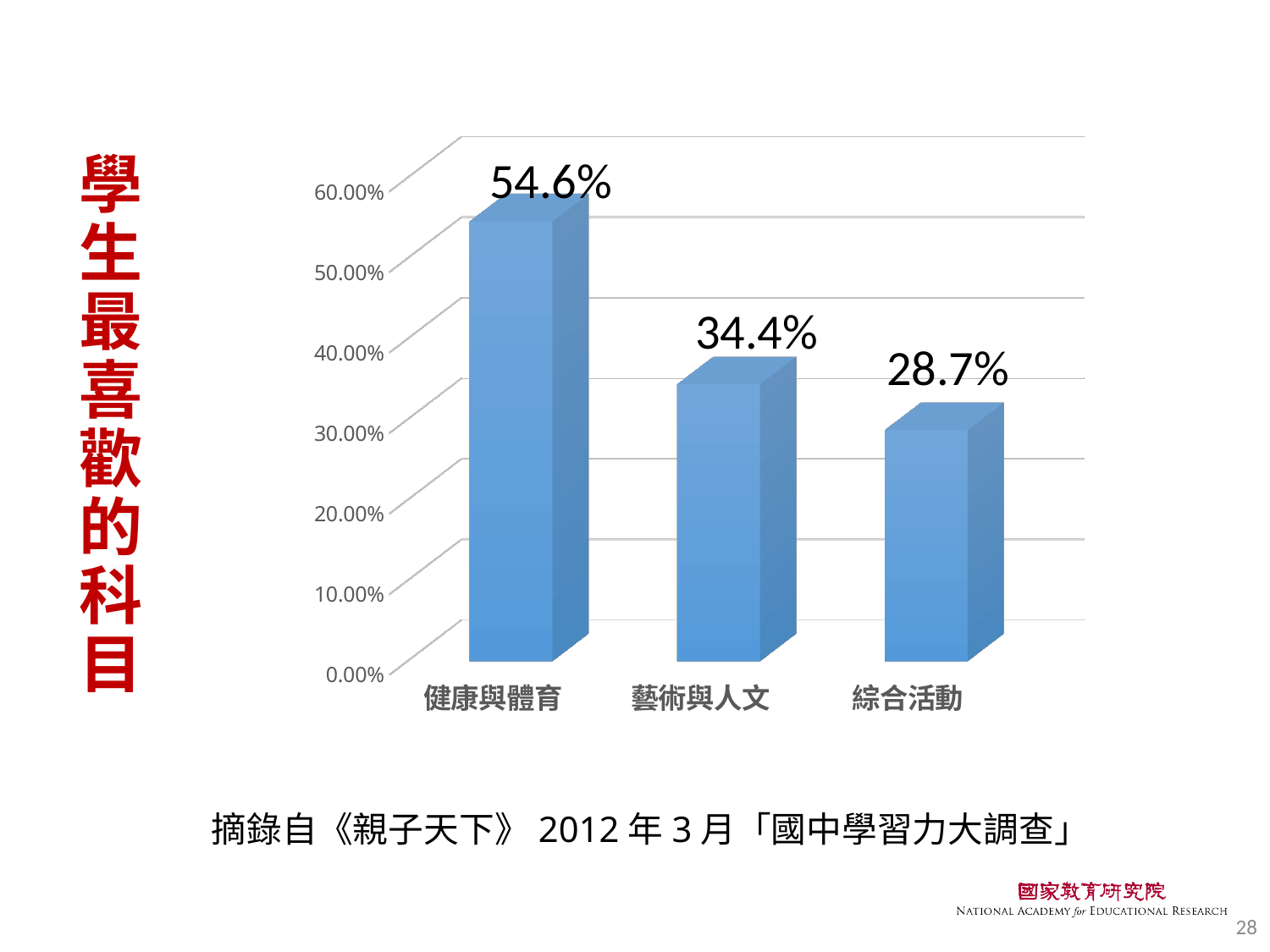
What is the difference between the values for 藝術與人文 and 綜合活動? 5.7% Which is larger, the value for 藝術與人文 or the value for 綜合活動? 藝術與人文 How many categories are shown on the x axis? 3 What is the difference between the values for 健康與體育 and 藝術與人文? 20.2% Is the value for 健康與體育 greater or less than 50.00%? greater Which category has the lowest value? 綜合活動 What is the value for 藝術與人文? 34.4% Do the values rise or fall from left to right along the x axis? fall What is the value for 健康與體育? 54.6% Which category has the highest value? 健康與體育 What is the value for 綜合活動? 28.7% What kind of chart is shown on the slide? bar chart